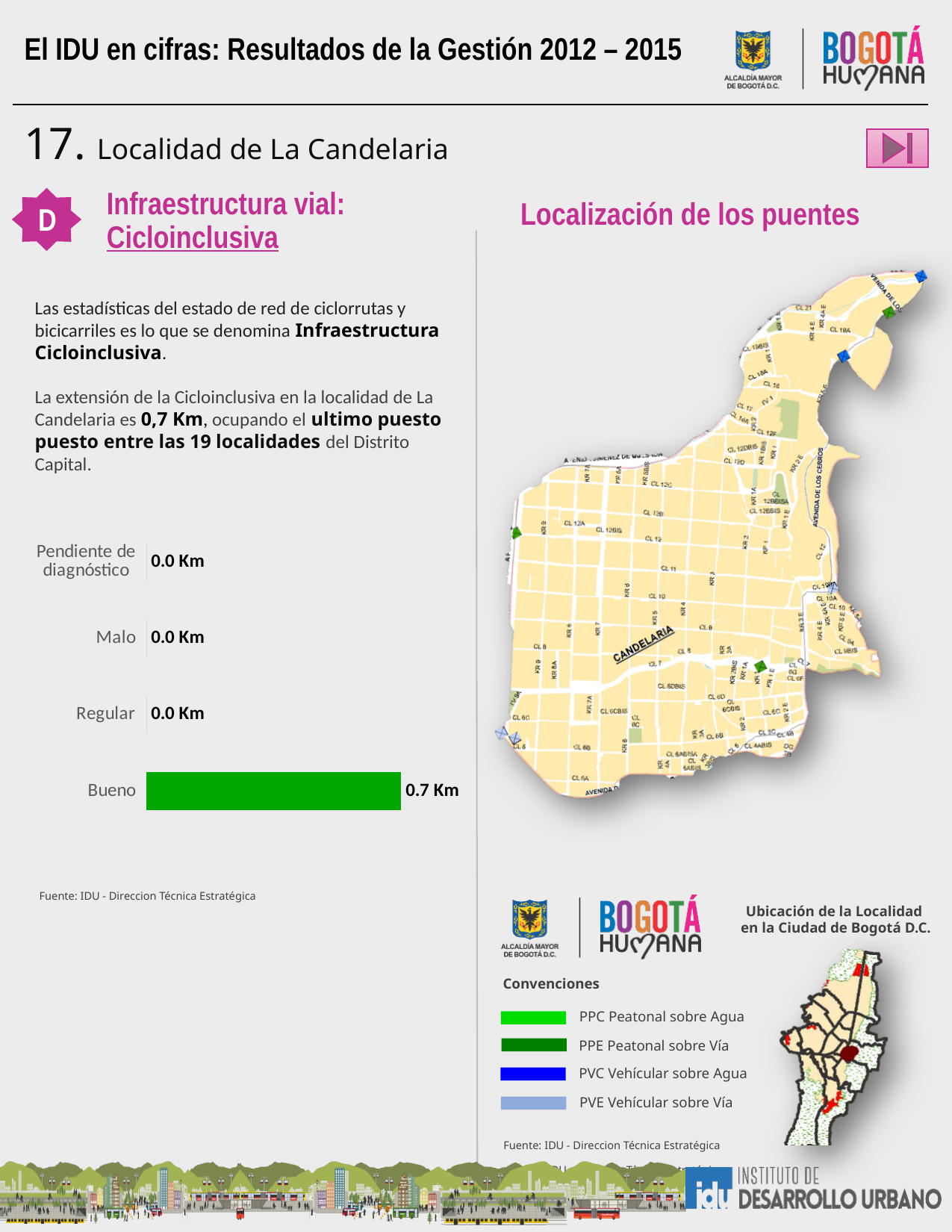
How many categories are shown in the bar chart? 4 What is the value for Regular in the bar chart? 0.0 Km What is the total of all the values shown in the bar chart? 0.7 Km What is the difference between the values for Bueno and Regular in the bar chart? 0.7 Km What is the value for Malo in the bar chart? 0.0 Km What is the value for Pendiente de diagnóstico in the bar chart? 0.0 Km What colour is the bar for Bueno in the bar chart? Green Which category has the highest value in the bar chart? Bueno What kind of chart is used to show the state of the cycling infrastructure? Bar chart Which is larger in the bar chart, the value for Bueno or the value for Malo? Bueno What is the value for Bueno in the bar chart? 0.7 Km What source is cited below the bar chart? IDU - Direccion Técnica Estratégica